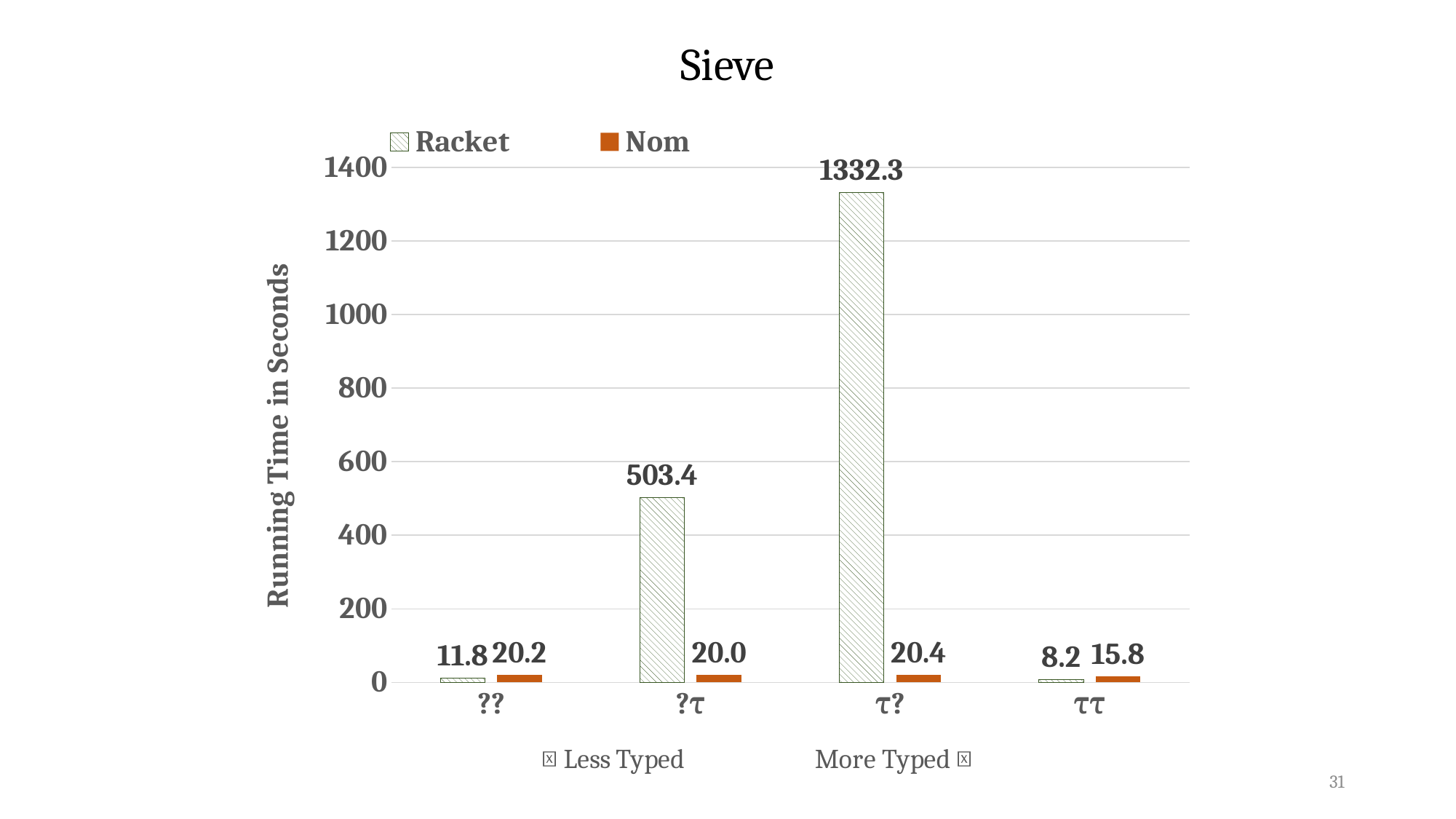
Is the Racket running time for the ?τ configuration greater or less than 400? greater What kind of chart is shown on the slide? bar chart What is the Racket running time for the ττ configuration? 8.2 Which is larger for the ?? configuration, the Racket or the Nom running time? Nom How many configurations are shown on the x axis? 4 Which configuration has the highest Racket running time? τ? What is the Racket running time for the τ? configuration? 1332.3 What is the Nom running time for the ?τ configuration? 20.0 What is the label of the vertical axis? Running Time in Seconds Which configuration has the lowest Nom running time? ττ How many series does the legend list? 2 What is the difference between the Racket and Nom running times for the ?τ configuration? 483.4